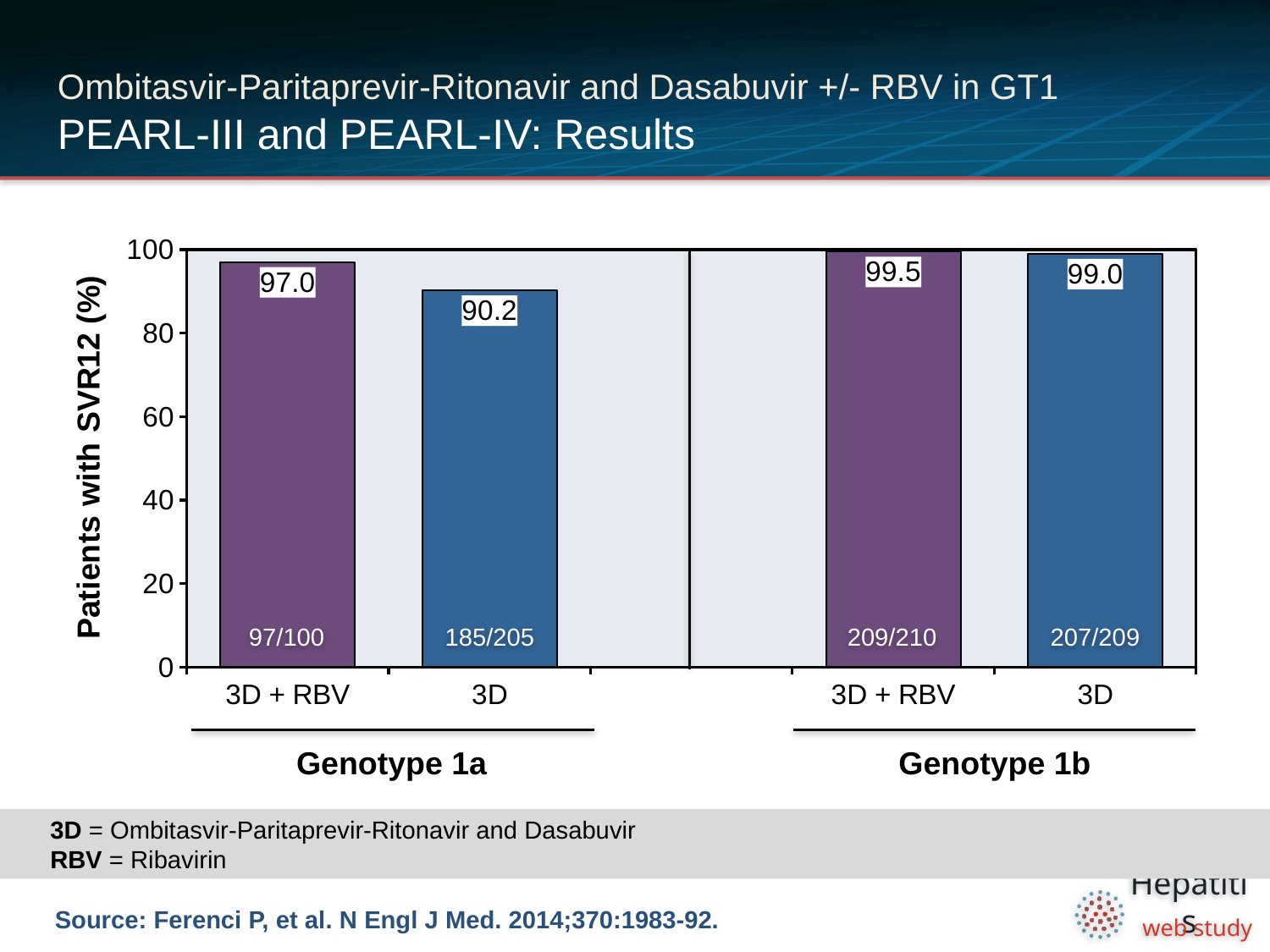
What is the SVR12 rate for 3D + RBV in Genotype 1a? 97.0 What is the label of the y axis? Patients with SVR12 (%) What fraction of patients achieved SVR12 with 3D alone in Genotype 1a? 185/205 What is the difference in SVR12 rate between 3D + RBV and 3D in Genotype 1a? 6.8 What kind of chart is shown on the slide? Bar chart Which bar has the lowest SVR12 rate? 3D, Genotype 1a Which is larger: the SVR12 rate for 3D in Genotype 1a or 3D in Genotype 1b? 3D in Genotype 1b What fraction of patients achieved SVR12 with 3D + RBV in Genotype 1b? 209/210 What is the SVR12 rate for 3D alone in Genotype 1b? 99.0 How many bars are plotted in the chart? 4 Which bar has the highest SVR12 rate? 3D + RBV, Genotype 1b What is the difference in SVR12 rate between 3D + RBV and 3D in Genotype 1b? 0.5